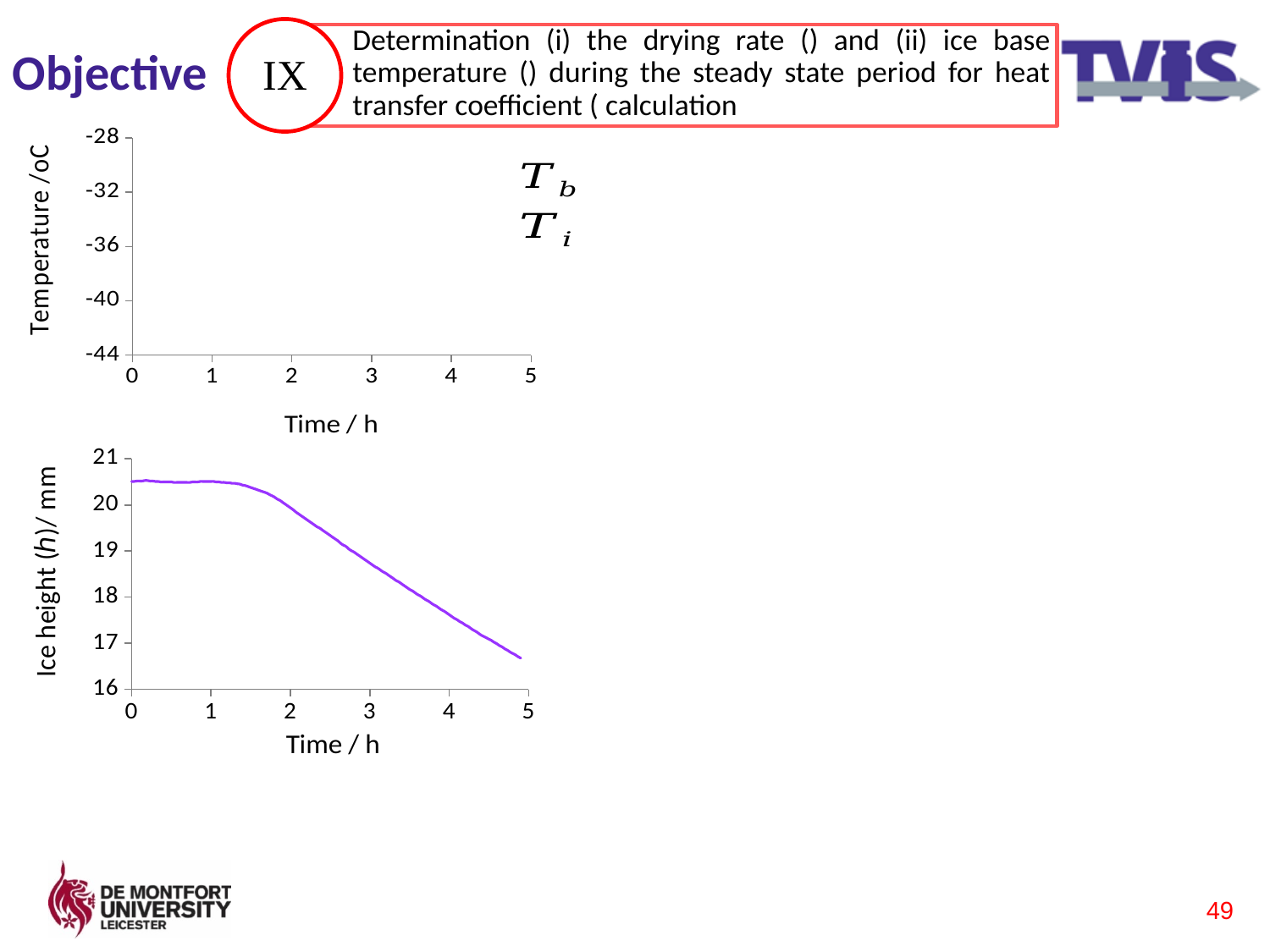
In the bottom chart (Ice height vs Time), is the ice height at 4 h greater or less than 17 mm? greater In the bottom chart (Ice height vs Time), is the ice height at 0 h greater or less than 20 mm? greater In the bottom chart (Ice height vs Time), is the ice height at 1 h greater or less than 20 mm? greater In the bottom chart, what is the label of the y axis? Ice height (h)/ mm In the bottom chart (Ice height vs Time), which is larger: the ice height at 1 h or at 4 h? 1 h In the top chart, what is the label of the y axis? Temperature /oC In the bottom chart (Ice height vs Time), does the ice height rise or fall as time increases? fall In the bottom chart (Ice height vs Time), is the ice height lowest at the start or at the end of the time range? end What kind of chart is the bottom chart (Ice height vs Time)? line chart